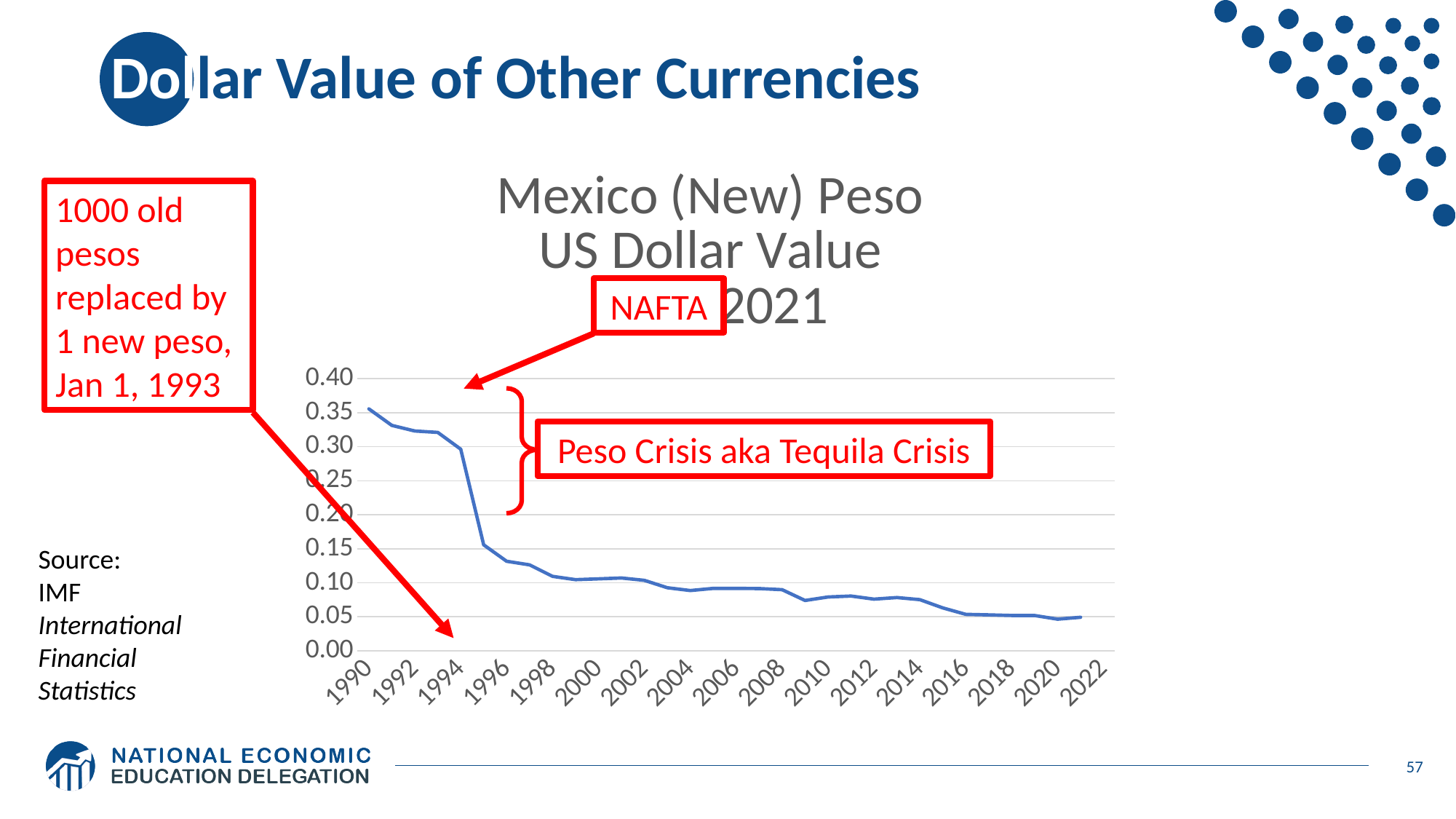
Which year has the larger value, 1990 or 2000? 1990 Is the value for 1996 greater or less than 0.20? less In which year is the US dollar value of the peso highest? 1990 Overall, does the US dollar value of the Mexican peso rise or fall from 1990 to 2021? fall Is the value for 1994 greater or less than 0.25? greater How many year labels are shown on the x axis? 17 What kind of chart is shown on the slide? line chart What is the title of the chart? Mexico (New) Peso US Dollar Value 1990-2021 Is the value for 2010 greater or less than 0.10? less Which year has the larger value, 1994 or 1996? 1994